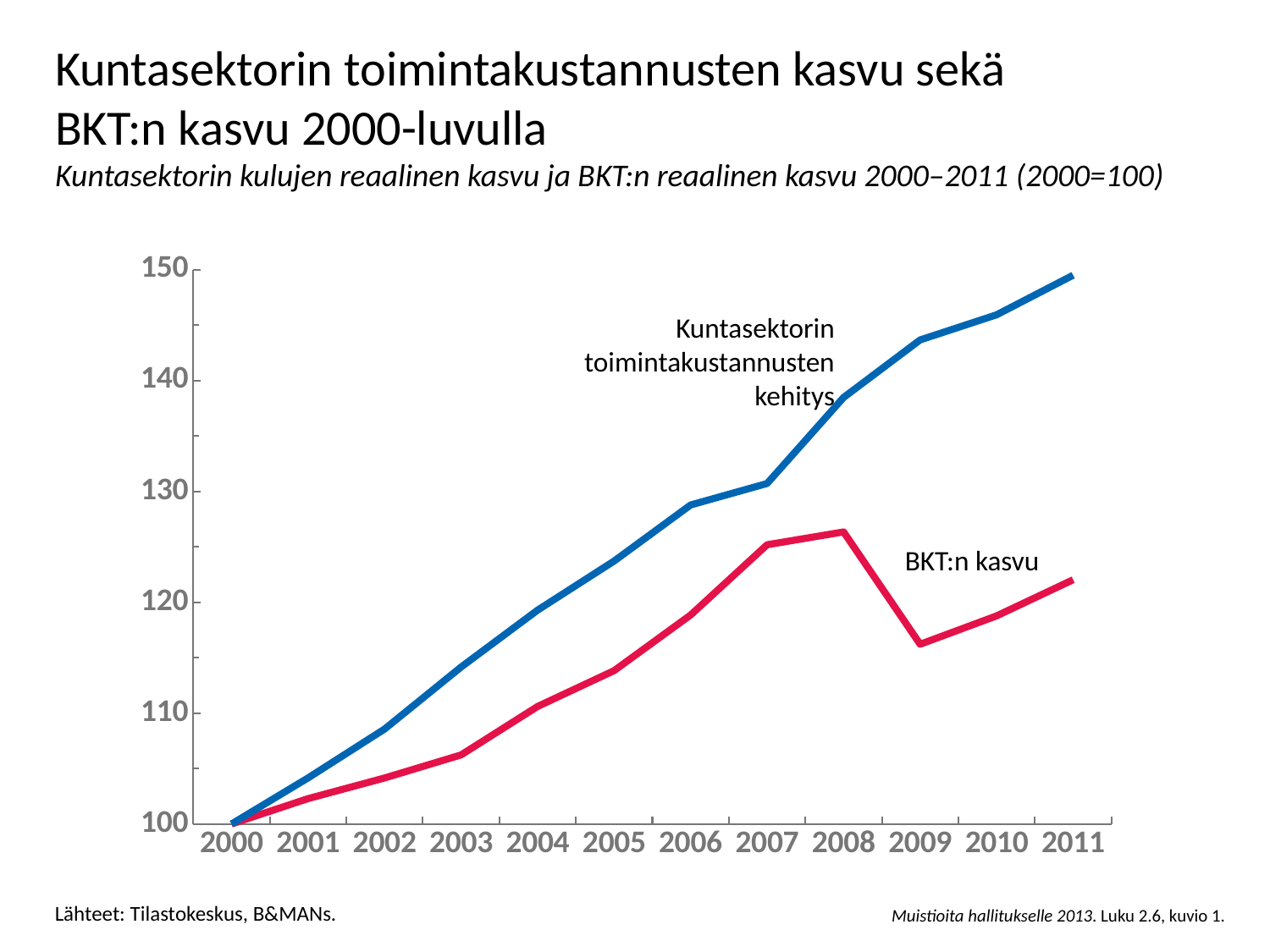
How many series are plotted on the chart? 2 In which year does BKT:n kasvu reach its highest value? 2008 Does the Kuntasektorin toimintakustannusten kehitys line rise or fall from 2000 to 2011? rise In 2011, which series has the higher value, Kuntasektorin toimintakustannusten kehitys or BKT:n kasvu? Kuntasektorin toimintakustannusten kehitys What colour is the BKT:n kasvu line? red How many years are shown on the x axis of the chart? 12 Is the value for Kuntasektorin toimintakustannusten kehitys in 2011 greater or less than 140? greater Is the value for BKT:n kasvu in 2009 greater or less than 120? less What kind of chart is shown on the slide? line chart Is the value for Kuntasektorin toimintakustannusten kehitys in 2006 greater or less than 130? less What is the value of both series in 2000? 100